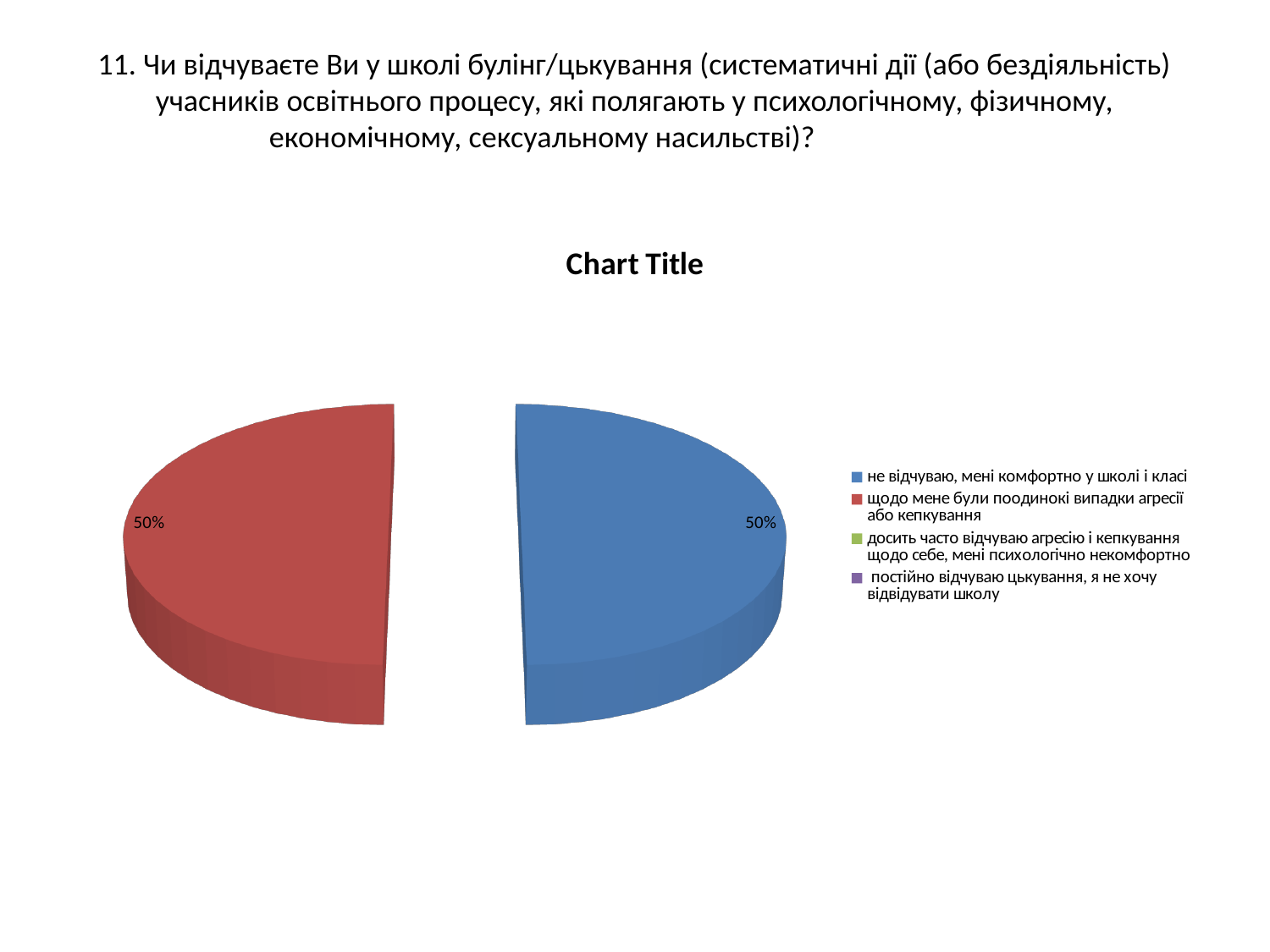
Which colour represents "не відчуваю, мені комфортно у школі і класі" in the legend? blue How many slices are visible in the pie chart? 2 What share of the pie does the slice for "щодо мене були поодинокі випадки агресії або кепкування" represent? 50% What is the difference between the blue slice and the red slice values? 0% What is the title shown above the pie chart? Chart Title What share of the pie does the slice for "не відчуваю, мені комфортно у школі і класі" represent? 50% What kind of chart is shown on the slide? pie chart What is the combined share of the blue and red slices? 100% How many entries does the legend list? 4 What value is labelled on the blue slice of the pie? 50% What value is labelled on the red slice of the pie? 50%